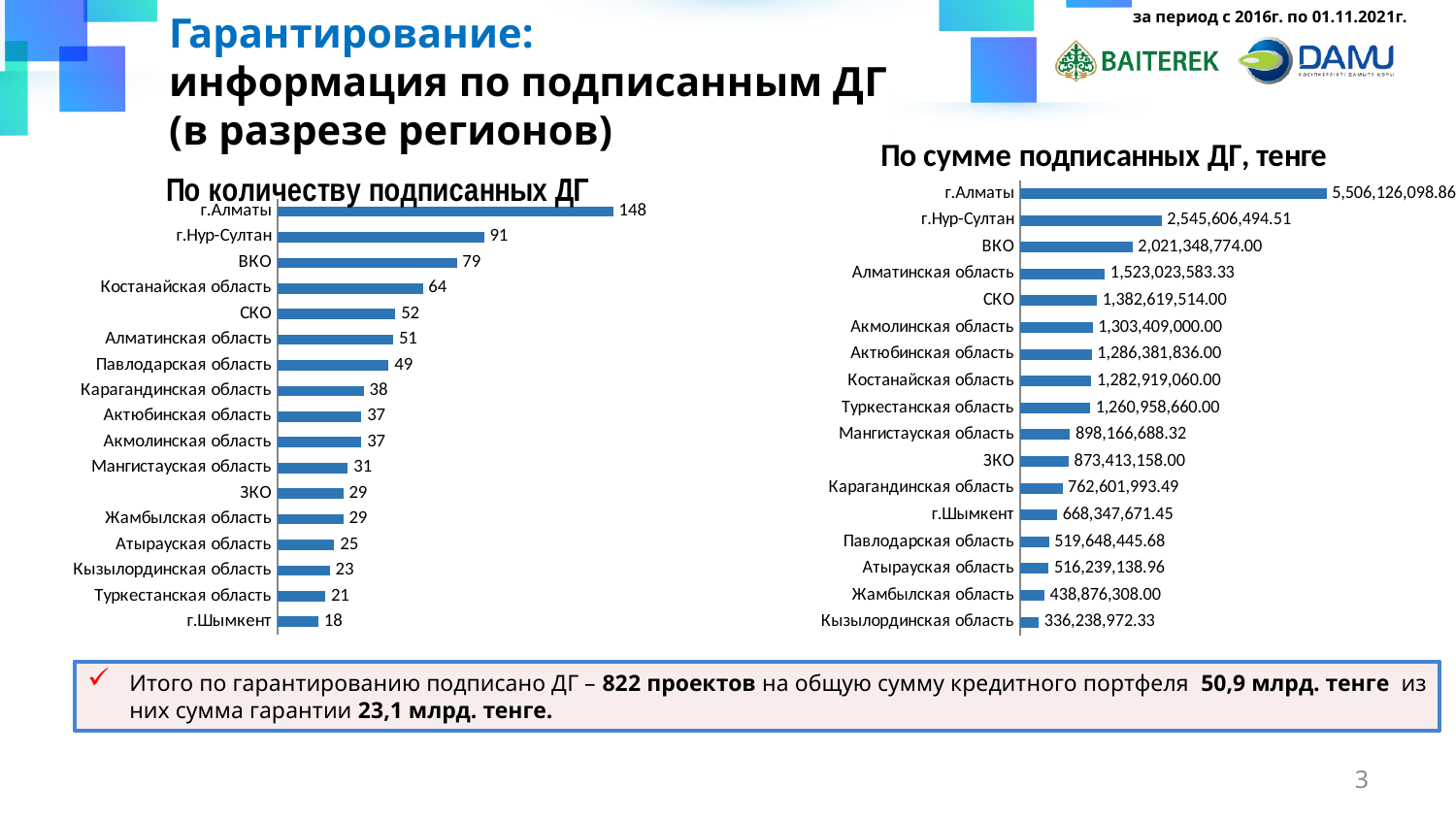
In the chart "По сумме подписанных ДГ, тенге", what is the value for Кызылординская область? 336,238,972.33 In the chart "По сумме подписанных ДГ, тенге", what is the value for ВКО? 2,021,348,774.00 In the chart "По сумме подписанных ДГ, тенге", which region has the highest value? г.Алматы In the chart "По сумме подписанных ДГ, тенге", which is larger: Мангистауская область or ЗКО? Мангистауская область What type of chart is "По сумме подписанных ДГ, тенге"? Bar chart In the chart "По сумме подписанных ДГ, тенге", what is the value for г.Шымкент? 668,347,671.45 In the chart "По количеству подписанных ДГ", what is the difference between г.Алматы and ВКО? 69 In the chart "По количеству подписанных ДГ", how many regions are shown? 17 In the chart "По количеству подписанных ДГ", which is larger: Костанайская область or СКО? Костанайская область In the chart "По количеству подписанных ДГ", what is the value for Туркестанская область? 21 In the chart "По количеству подписанных ДГ", what is the value for г.Нур-Султан? 91 In the chart "По количеству подписанных ДГ", which region has the lowest value? г.Шымкент